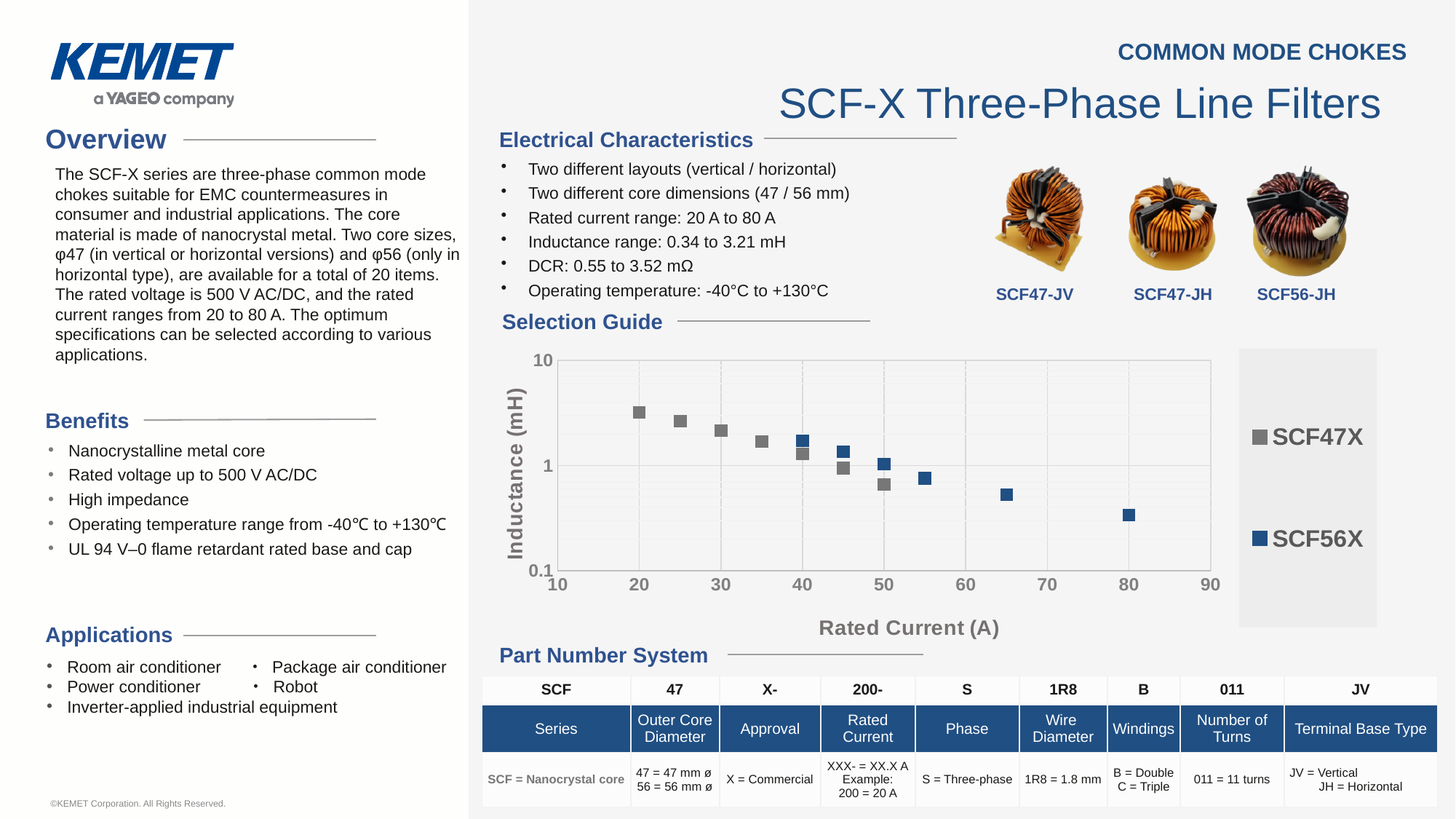
What is the label of the y axis of the Selection Guide chart? Inductance (mH) How many series does the legend of the Selection Guide chart list? 2 In the Selection Guide chart, which series has the point with the lowest inductance? SCF56X What are the two series named in the legend of the Selection Guide chart? SCF47X and SCF56X In the Selection Guide chart, is the inductance of the SCF56X point at 80 A greater or less than 1 mH? less In the Selection Guide chart, at 40 A, which series has the higher inductance, SCF47X or SCF56X? SCF56X In the Selection Guide chart, is the inductance of the SCF47X point at 50 A greater or less than 1 mH? less In the Selection Guide chart, is the inductance of the SCF47X point at 20 A greater or less than 1 mH? greater In the Selection Guide chart, does inductance rise or fall as rated current increases? fall How many SCF56X points are plotted in the Selection Guide chart? 6 In the Selection Guide chart, which series has the point with the highest inductance? SCF47X What kind of chart is shown in the Selection Guide? scatter chart